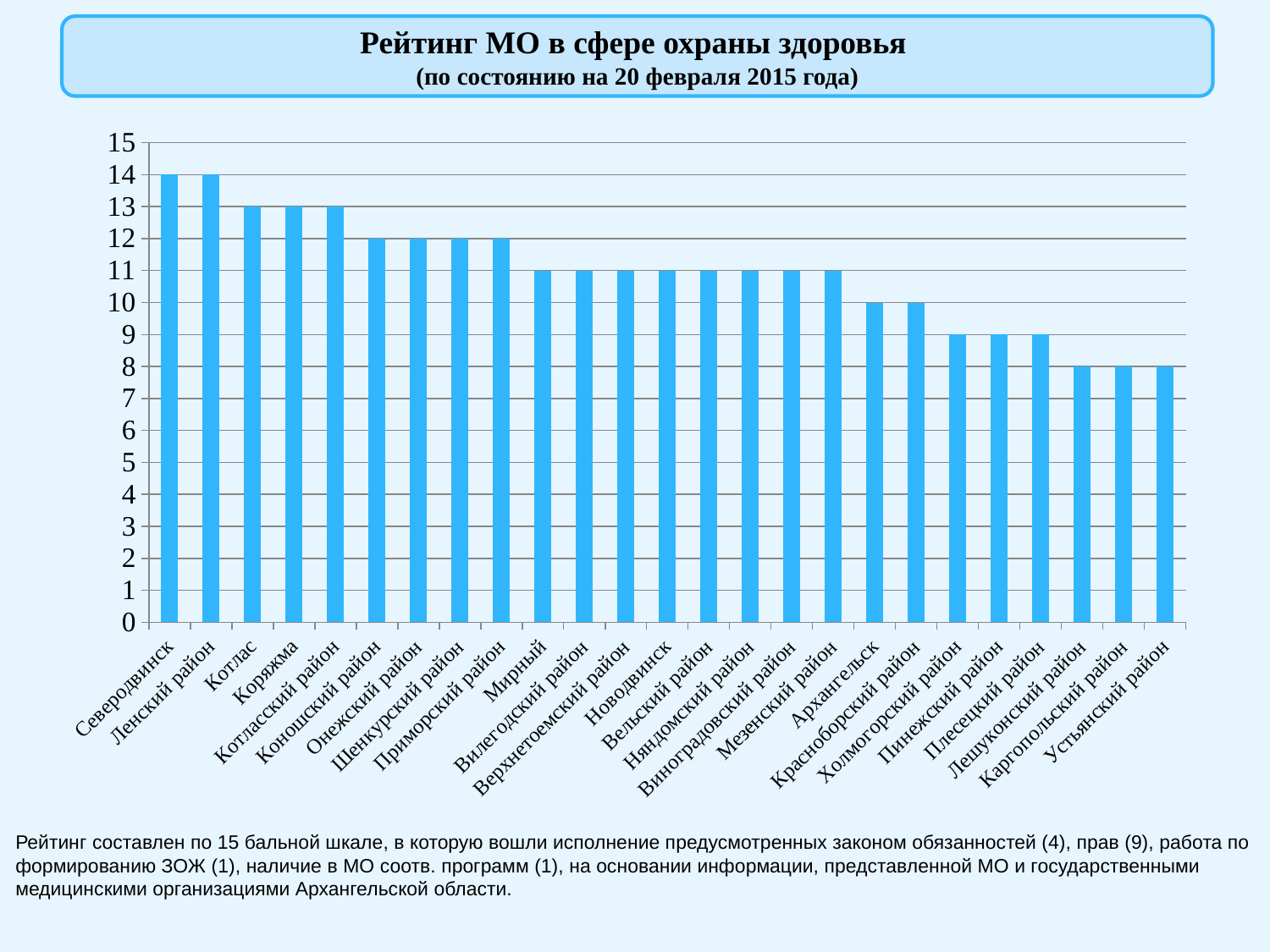
What is the value for Котлас? 13 What is the difference between the values for Северодвинск and Устьянский район? 6 What kind of chart is shown on the slide? bar chart What is the value for Архангельск? 10 Is the value for Архангельск greater or less than 12? less What is the title of the chart? Рейтинг МО в сфере охраны здоровья (по состоянию на 20 февраля 2015 года) Do the values rise or fall from left to right along the x axis? fall Which has a larger value, Котлас or Архангельск? Котлас What is the value for Устьянский район? 8 What is the value for Северодвинск? 14 What is the value for Мирный? 11 How many categories are plotted on the chart? 25